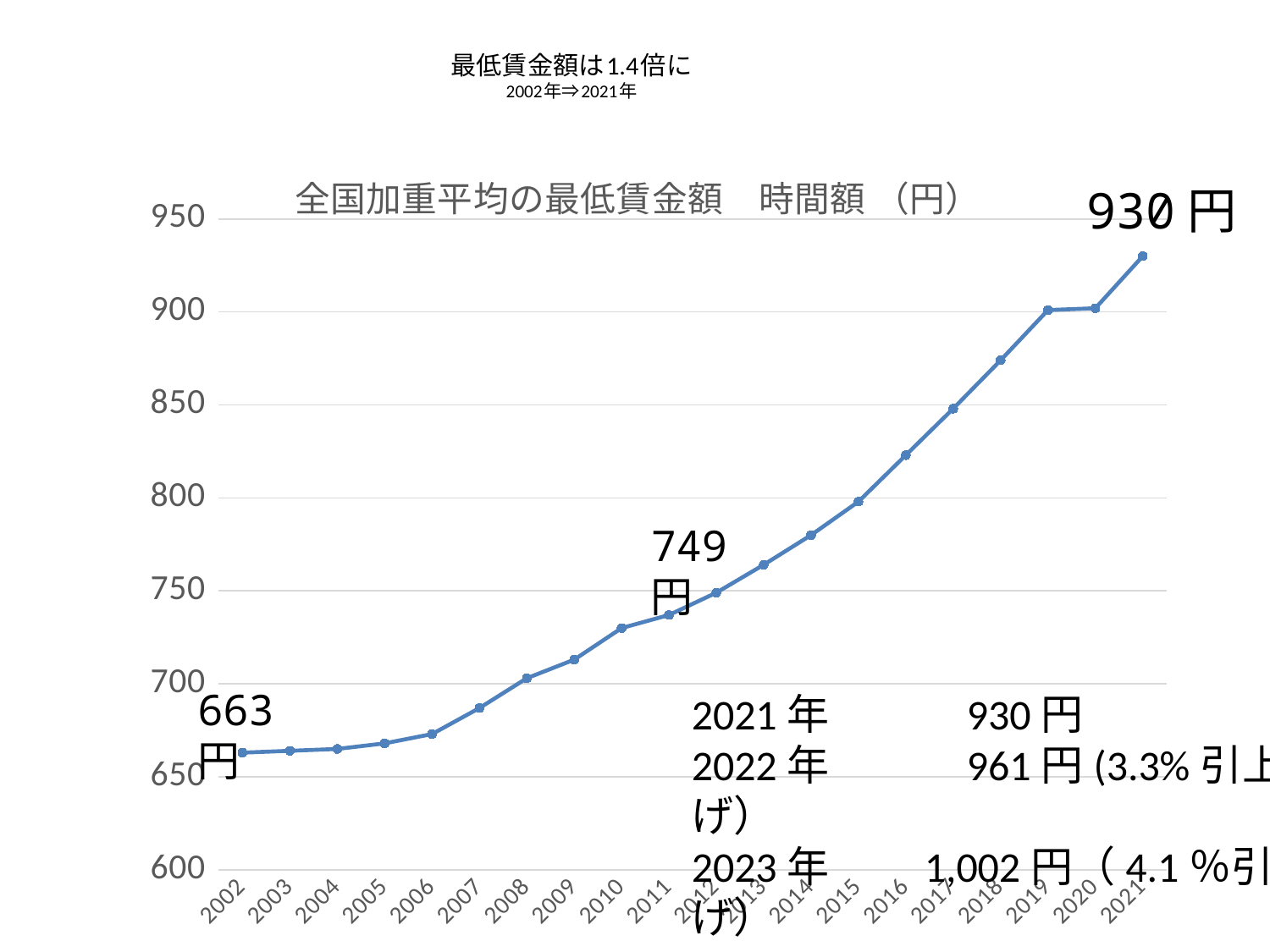
By how much did the labelled value increase from 2002 to 2021? 267円 Which year has the larger value, 2005 or 2010? 2010 Is the value for 2018 greater or less than 850? greater How many years are plotted on the x axis? 20 What is the title of the chart? 全国加重平均の最低賃金額 時間額（円） What kind of chart is shown on the slide? line chart What is the minimum wage value labelled for 2021? 930円 Do the values rise or fall from 2002 to 2021? rise Which year has the lowest value on the chart? 2002 Which year has the highest value on the chart? 2021 What is the minimum wage value labelled for 2002? 663円 Is the value for 2014 greater or less than 800? less